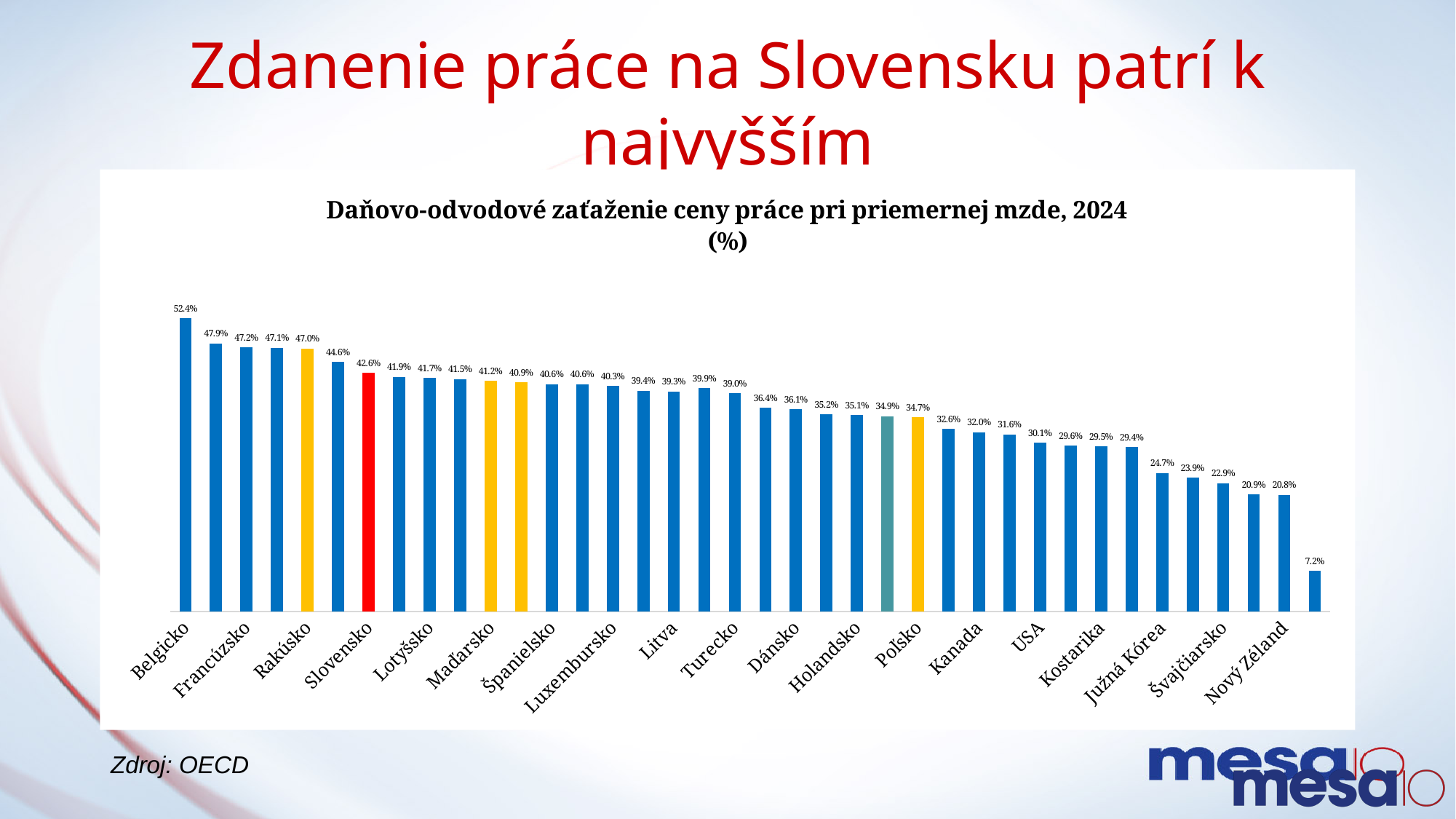
Which country has the highest value in the chart? Belgicko What is the value for Belgicko? 52.4% What is the difference between the values for Belgicko and Slovensko? 9.8 percentage points What is the value for Nový Zéland? 20.8% What type of chart is shown on the slide? bar chart What is the title of the chart? Daňovo-odvodové zaťaženie ceny práce pri priemernej mzde, 2024 (%) What is the value for Slovensko? 42.6% What is the value for Rakúsko? 47.0% What colour is the bar for Slovensko? red Do the values rise or fall from left to right along the x axis? fall Which is larger, the value for Belgicko or the value for Slovensko? Belgicko What is the lowest value shown in the chart? 7.2%